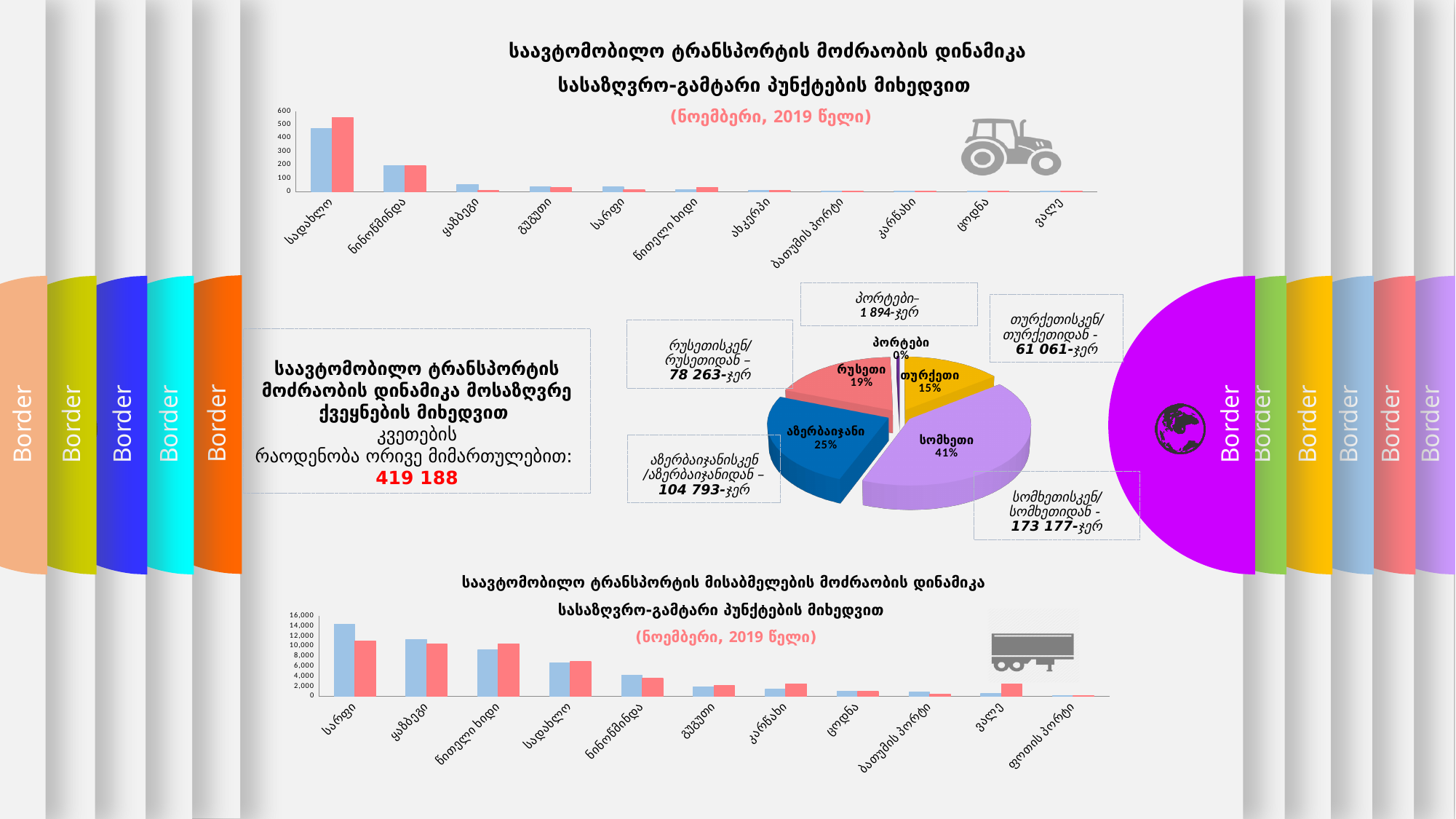
In the pie chart in the middle of the slide, how many slices are there? 5 What kind of chart is the chart at the top of the slide? bar chart In the bar chart at the top of the slide, how many categories are shown on the x axis? 11 In the pie chart in the middle of the slide, what share does სომხეთი have? 41% In the pie chart in the middle of the slide, what is the difference in percentage points between the სომხეთი and რუსეთი slices? 22 In the bar chart at the bottom of the slide, which category has the highest bar? სარფი In the pie chart in the middle of the slide, what share does აზერბაიჯანი have? 25% In the bar chart at the bottom of the slide, is the value of the blue bar for სარფი greater or less than 12,000? greater In the pie chart in the middle of the slide, which slice is the largest? სომხეთი In the bar chart at the top of the slide, is the value of the blue bar for სადახლო greater or less than 400? greater In the pie chart in the middle of the slide, which slice is the smallest? პორტები In the pie chart in the middle of the slide, which is larger, the თურქეთი slice or the რუსეთი slice? რუსეთი